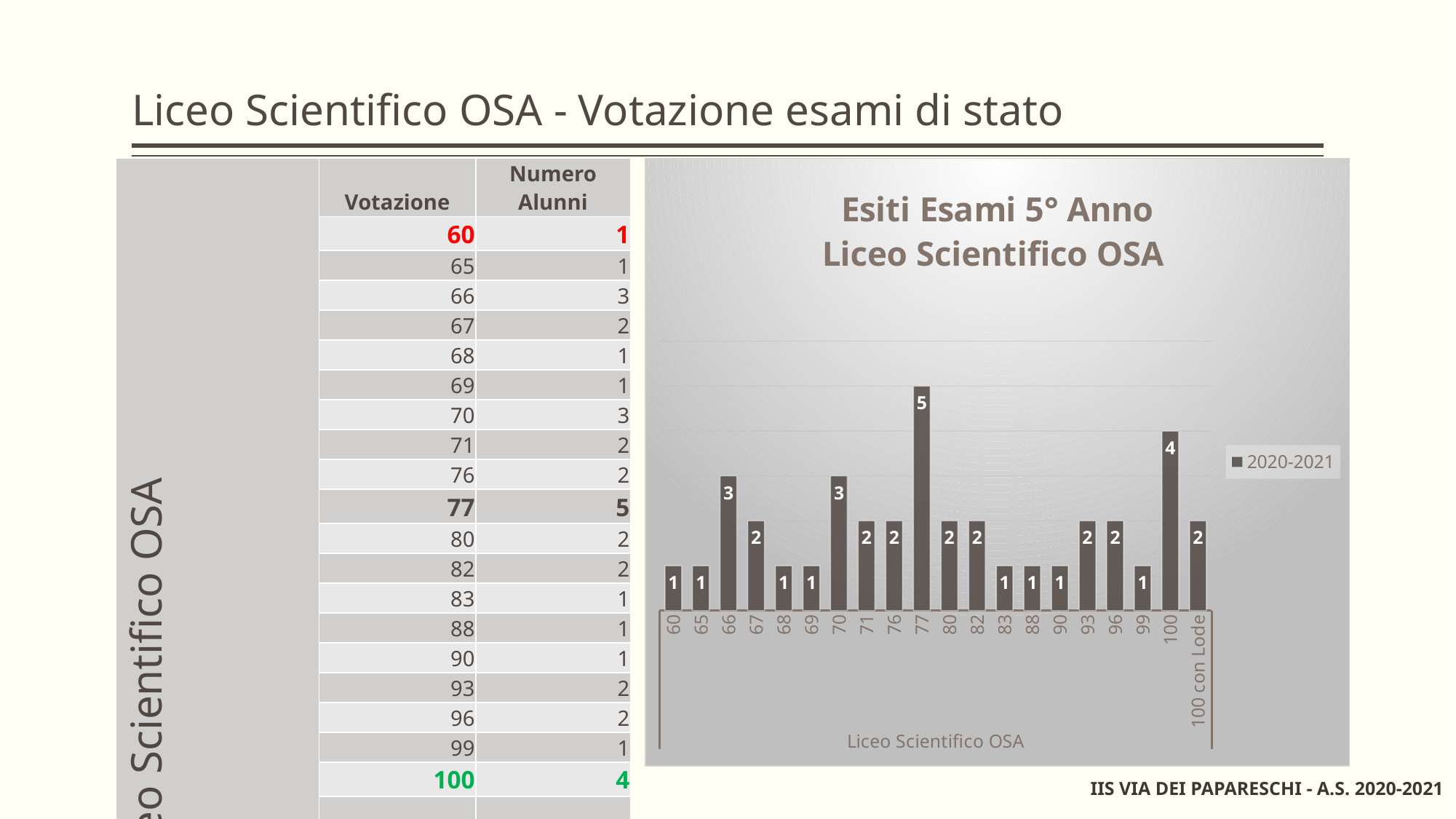
What is the value for the category 100 in the chart? 4 What is the legend entry of the chart? 2020-2021 What kind of chart is shown on the slide? bar chart Which category has the highest value in the chart? 77 What is the title of the chart? Esiti Esami 5° Anno Liceo Scientifico OSA What is the value for the category 77 in the chart? 5 What is the value for the category 66 in the chart? 3 How many series does the chart legend list? 1 What is the value for the category '100 con Lode' in the chart? 2 How many categories are shown on the x axis of the chart? 20 What is the difference between the values for 77 and 100 in the chart? 1 Which has a larger value in the chart, 70 or 71? 70